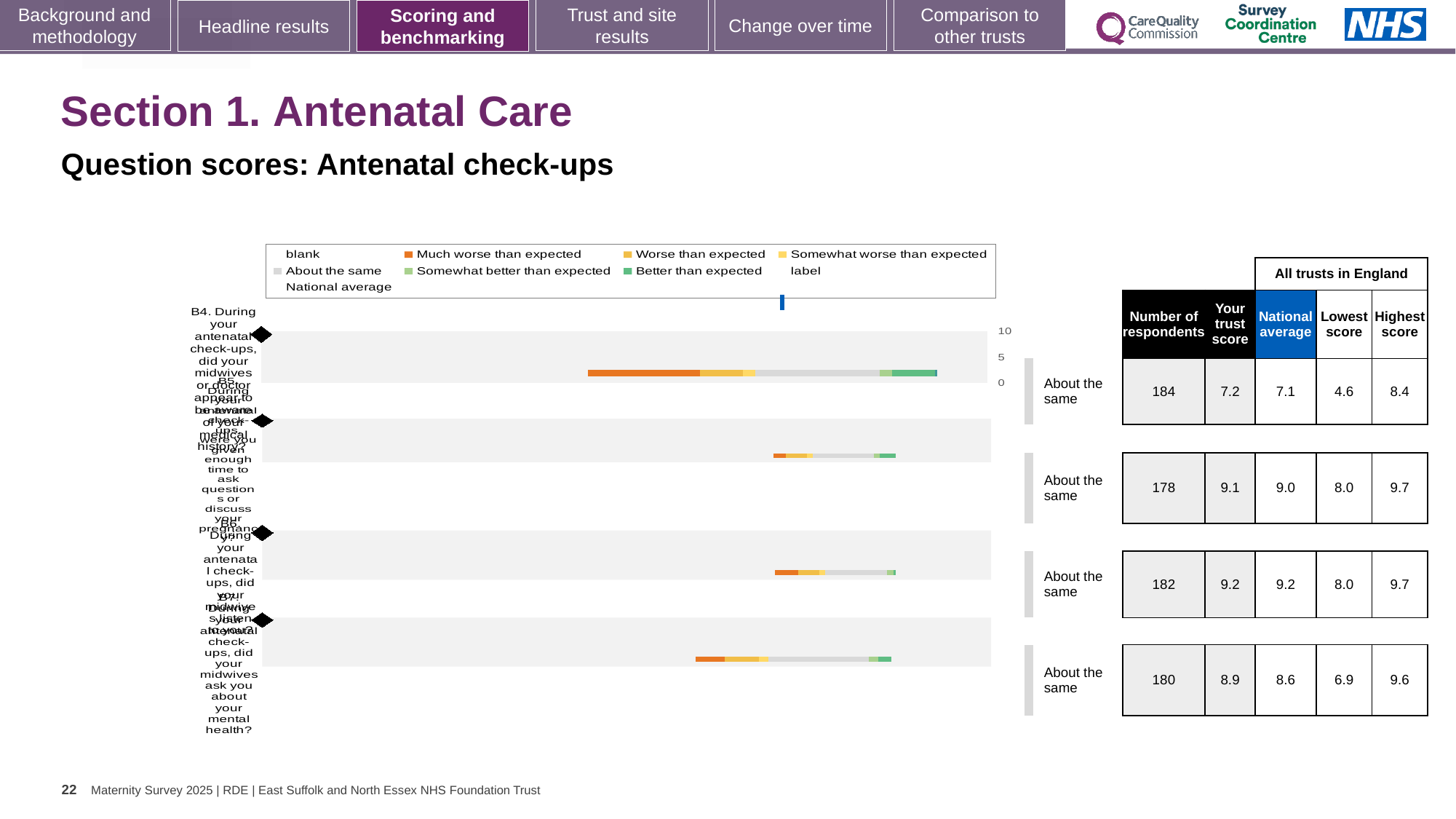
Which row has the lowest 'Your trust score'? the first row, B4 (7.2) What is the highest score among all trusts in England for the fourth row? 9.6 What kind of chart is shown on the slide? bar chart What colour does the legend use for 'Much worse than expected'? orange What is the 'Your trust score' for the first row (B4, awareness of medical history)? 7.2 What is the national average for the fourth row of the table? 8.6 For the first row (B4), which is larger: the trust score or the national average? the trust score (7.2) How many question bars are plotted in the chart? 4 What benchmark label is shown next to each of the four bars? About the same What is the difference between the trust score and the national average for the fourth row? 0.3 Which row has the highest 'Your trust score'? the third row (9.2) What is the number of respondents for the second row of the table? 178